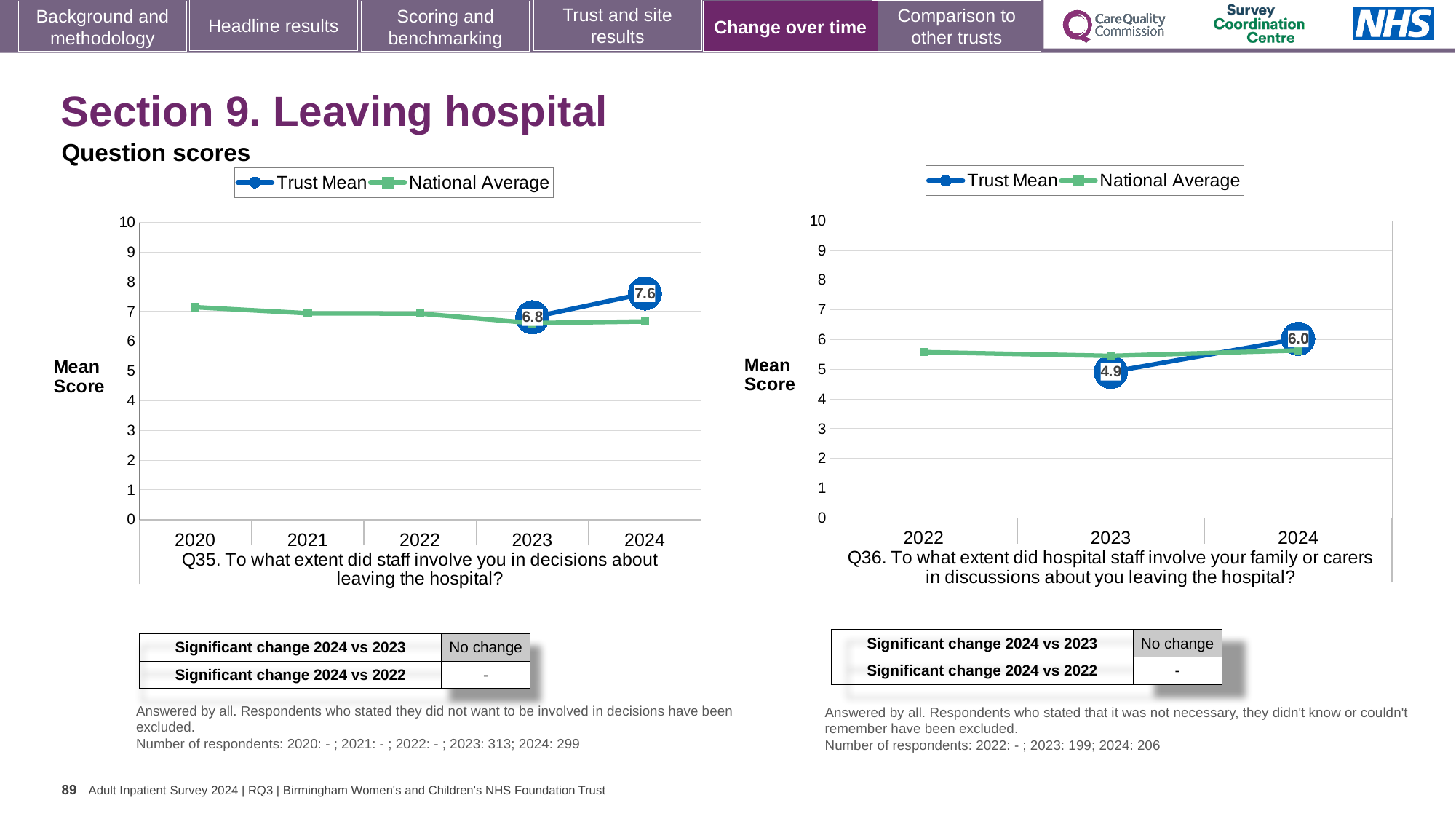
In the Q35 chart on the left, what is the Trust Mean score for 2024? 7.6 In the Q35 chart on the left, what is the Trust Mean score for 2023? 6.8 How many years are shown on the x axis of the Q35 chart on the left? 5 In the Q36 chart on the right, is the National Average for 2022 greater or less than 7? less In the Q35 chart on the left, is the National Average for 2020 greater or less than 5? greater In the Q35 chart on the left, by how much did the Trust Mean change from 2023 to 2024? 0.8 In the Q36 chart on the right, which year has the higher Trust Mean, 2023 or 2024? 2024 What type of chart is used for Q35 on the left? Line chart In the Q36 chart on the right, what is the Trust Mean score for 2024? 6.0 In the Q36 chart on the right, what is the difference between the Trust Mean in 2024 and in 2023? 1.1 How many series does the legend of the Q36 chart on the right list? 2 In the Q36 chart on the right, what is the Trust Mean score for 2023? 4.9